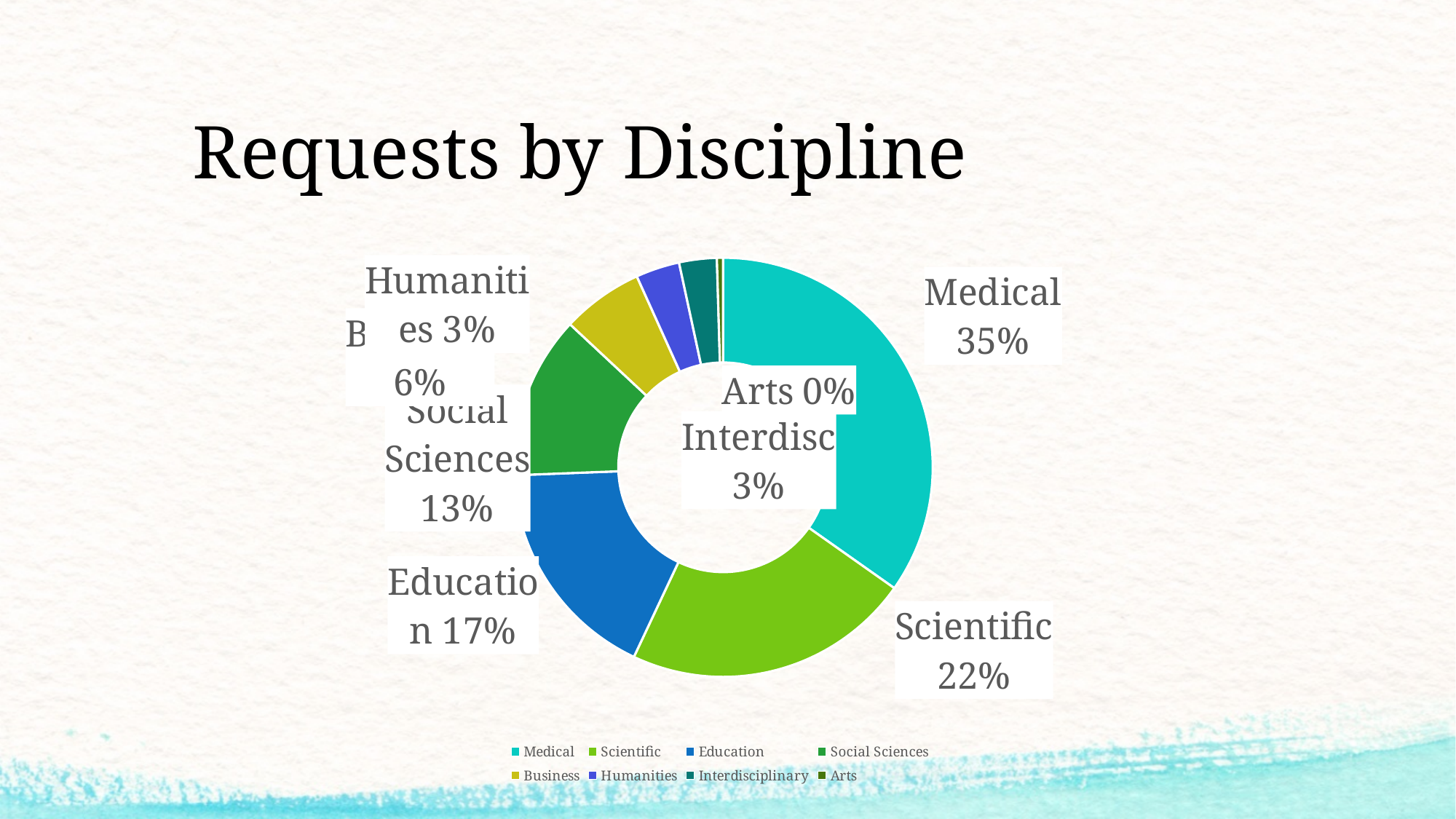
Which discipline has the smallest share of requests? Arts What is the title of the chart? Requests by Discipline What type of chart is shown on the slide? Pie chart (doughnut) What share of requests is Education? 17% What share of requests is Social Sciences? 13% What share of requests is Arts? 0% How many disciplines are listed in the legend? 8 Which has a larger share, Education or Social Sciences? Education What share of requests is Scientific? 22% Which discipline has the largest share of requests? Medical What share of requests is Medical? 35% What is the difference between the Medical and Scientific shares? 13%